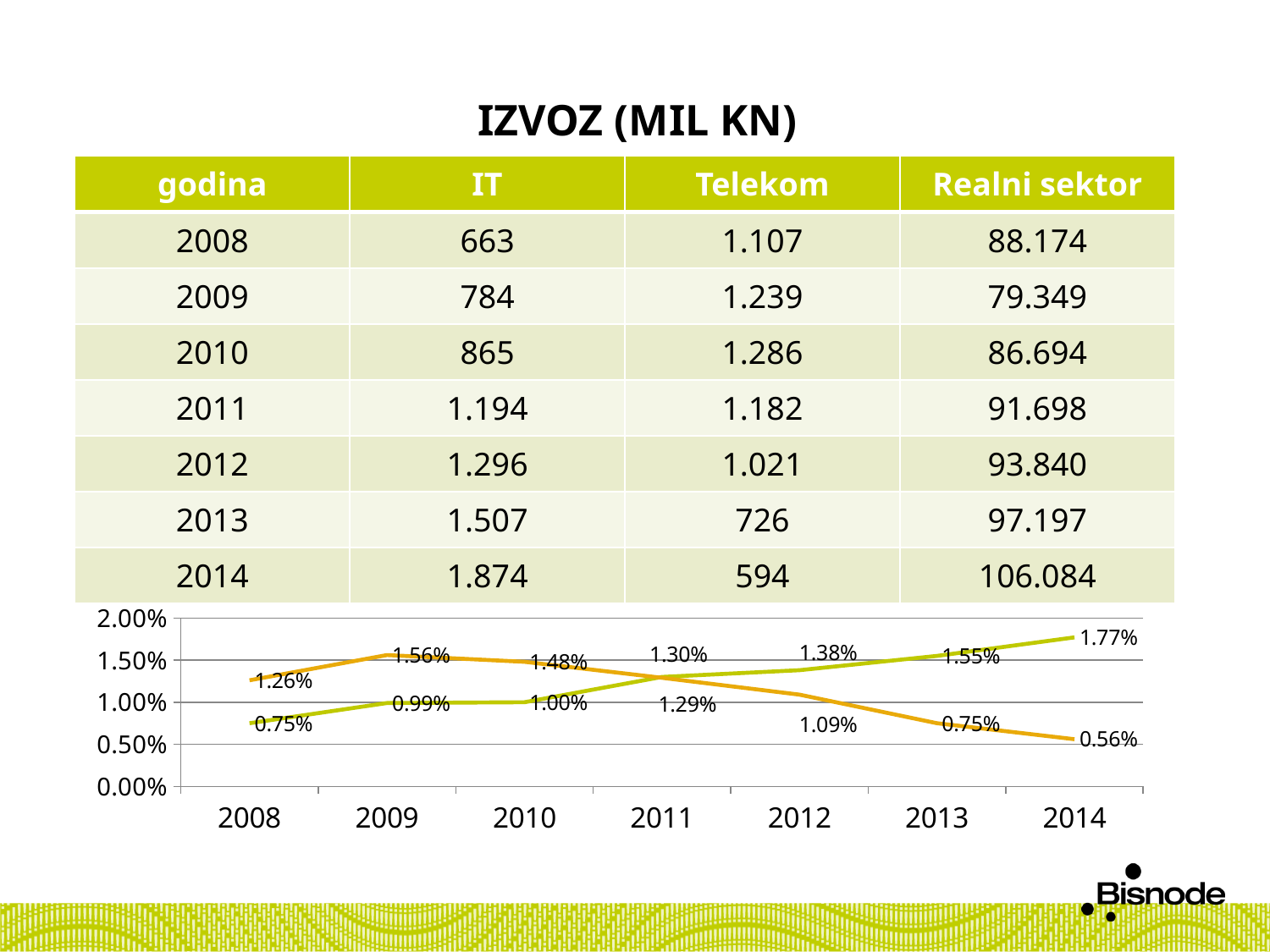
In the line chart, in which year does the orange line reach its lowest value? 2014 In the line chart, what is the value of the orange line for 2009? 1.56% In the line chart, what is the value of the green line for 2008? 0.75% In the line chart, does the green line rise or fall from 2008 to 2014? rises What kind of chart is shown below the table? line chart In the line chart, what is the value of the green line for 2014? 1.77% In the line chart, which line has the higher value in 2008, the orange line or the green line? orange line In the line chart, what is the value of the orange line for 2014? 0.56% How many years are plotted along the x axis of the line chart? 7 In the line chart, does the orange line rise or fall from 2009 to 2014? falls In the line chart, in which year does the green line reach its highest value? 2014 In the line chart, what is the difference between the green line and the orange line in 2014? 1.21%